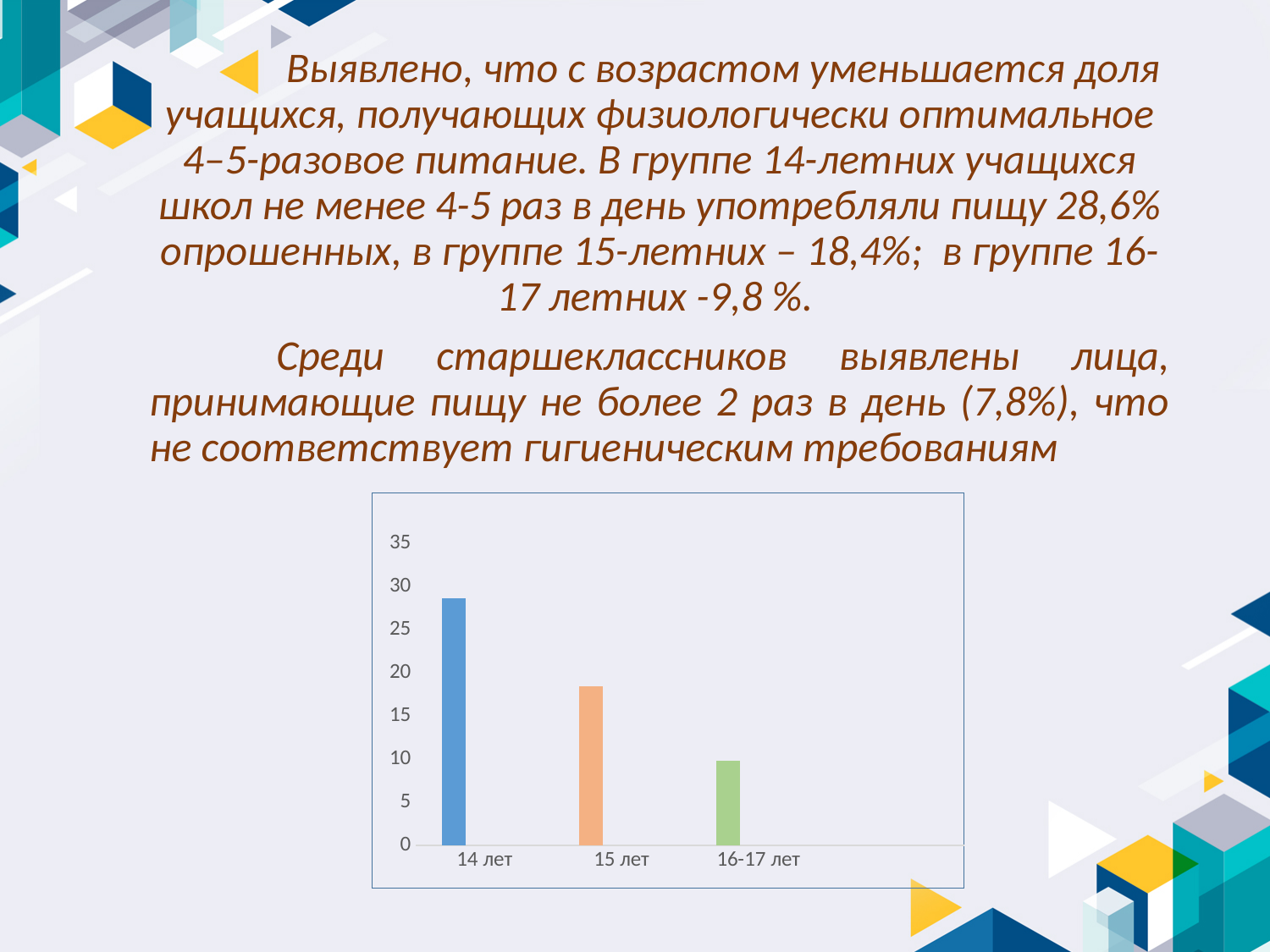
Which category has the lowest bar in the chart? 16-17 лет Is the value for 14 лет greater or less than 30? less Which is larger, the value for 15 лет or the value for 16-17 лет? 15 лет What kind of chart is shown on the slide? bar chart Is the value for 15 лет greater or less than 15? greater Is the value for 15 лет greater or less than 20? less How many categories are shown on the x axis of the chart? 3 What is the highest tick value shown on the vertical axis of the chart? 35 Do the bar values rise or fall from left to right along the x axis? fall Which category has the highest bar in the chart? 14 лет